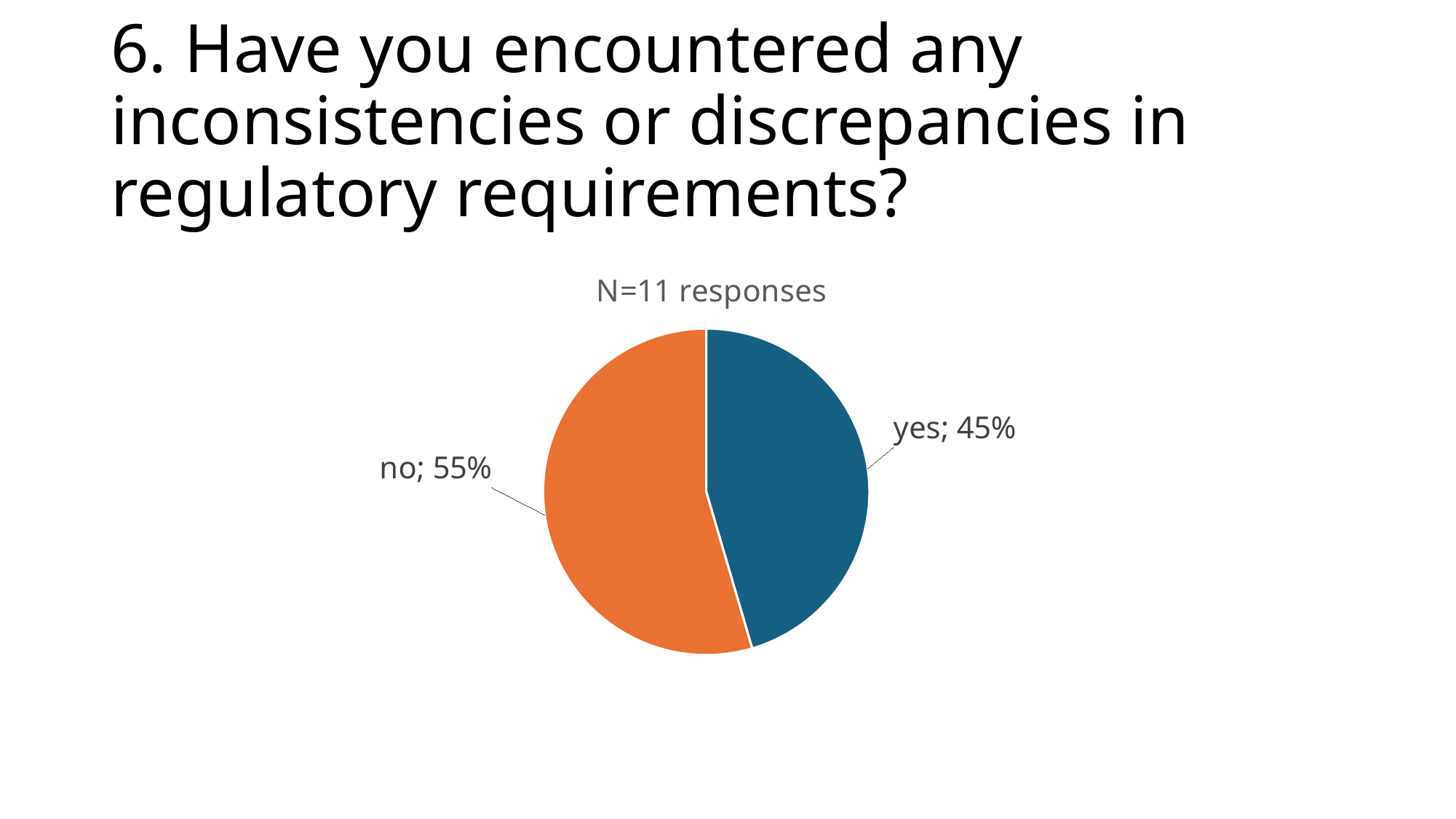
Which response has the smaller share of the pie? yes How many slices does the pie chart have? 2 What percentage of respondents answered "no"? 55% What percentage of respondents answered "yes"? 45% What kind of chart is shown on the slide? pie chart What is the difference in percentage points between the "no" and "yes" shares? 10 How many responses does the chart subtitle say were collected? 11 Which response has the larger share of the pie? no Is the share for "yes" larger or smaller than the share for "no"? smaller What colour is the "yes" slice? blue What share of the pie does the "no" slice represent? 55%